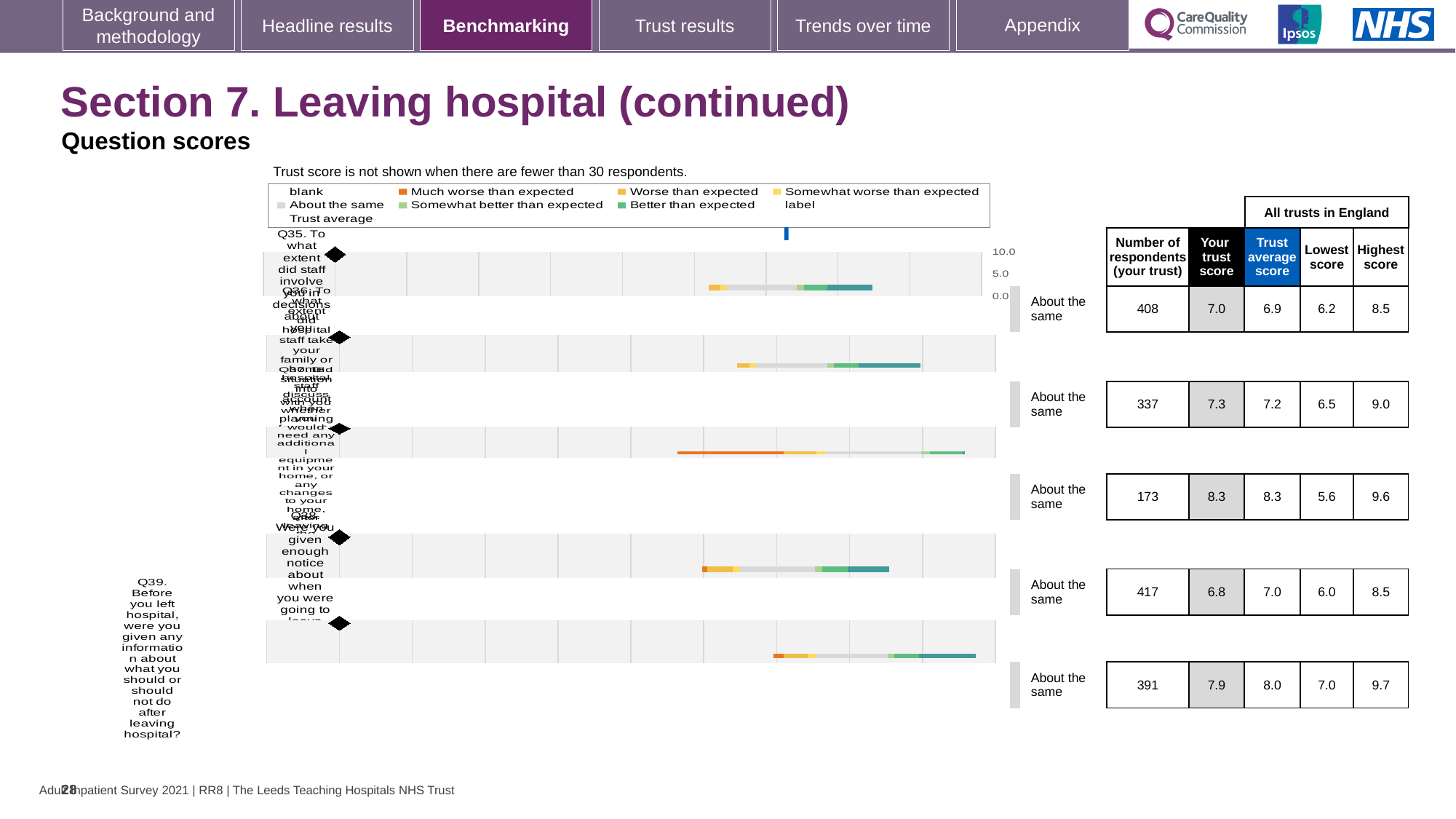
What is the trust score for Q35? 7.0 How many respondents answered Q37 at this trust? 173 Which question has the highest trust score? Q37 What kind of chart is shown? bar chart What is the trust average score for Q39? 8.0 What is the benchmark category shown for Q38? About the same What is the difference between the trust score for Q37 and the trust score for Q38? 1.5 What is the highest score across all trusts in England for Q36? 9.0 Is the trust score for Q39 greater or less than 5.0? greater Which has the larger trust score, Q35 or Q36? Q36 How many questions are plotted on the chart? 5 Which question has the lowest trust score? Q38